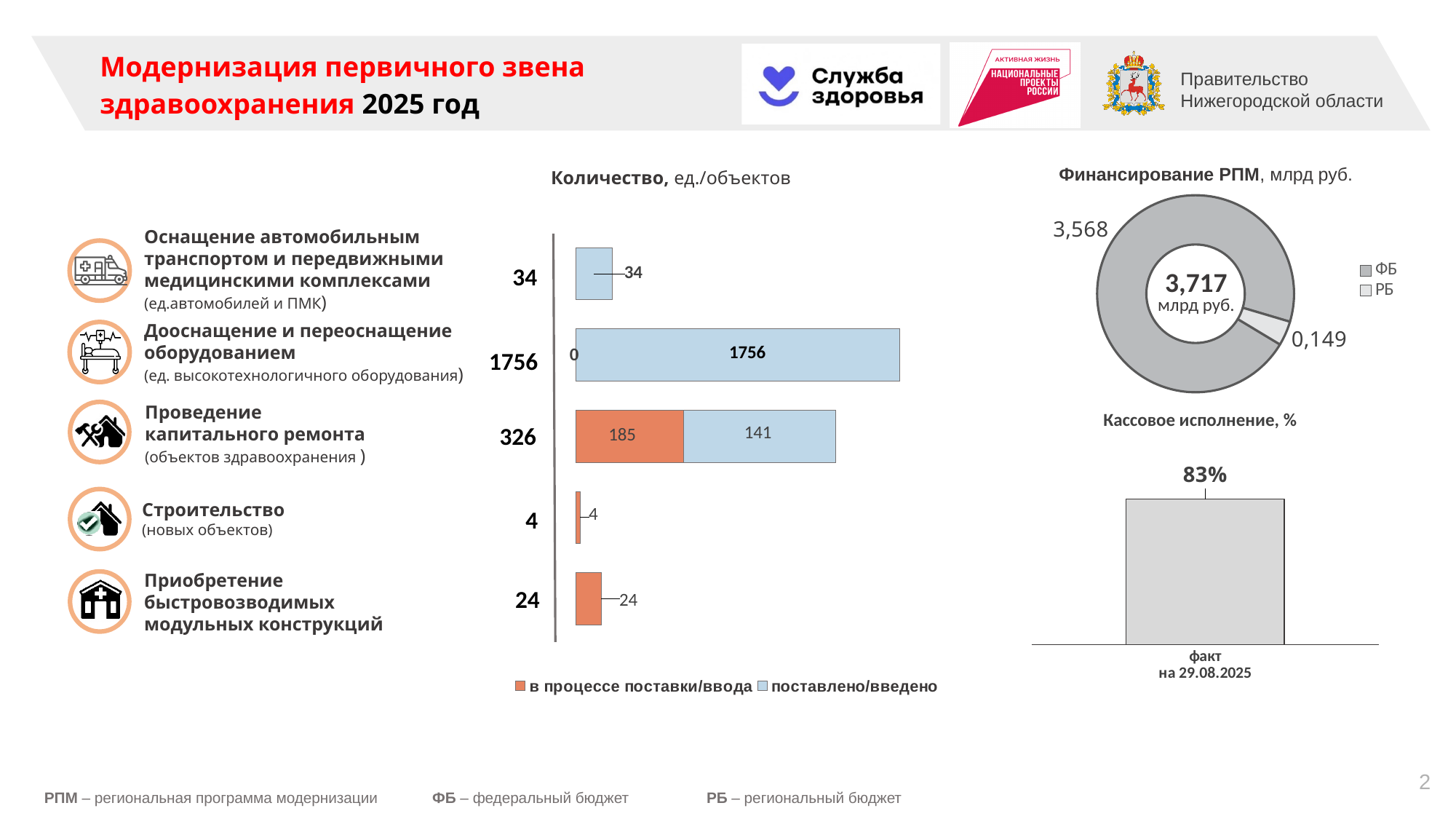
In the 'Финансирование РПМ, млрд руб.' donut chart, what is the value for РБ? 0,149 In the 'Кассовое исполнение, %' chart, what is the value for 'факт на 29.08.2025'? 83% What kind of chart is the 'Количество, ед./объектов' chart? bar chart In the 'Количество, ед./объектов' bar chart, what is the total of the stacked bar for 'Проведение капитального ремонта'? 326 In the 'Количество, ед./объектов' bar chart, what is the difference between the 'в процессе поставки/ввода' and 'поставлено/введено' values for 'Проведение капитального ремонта'? 44 In the 'Количество, ед./объектов' bar chart, what is the value for 'в процессе поставки/ввода' for 'Проведение капитального ремонта'? 185 In the 'Количество, ед./объектов' chart, how many series does the legend list? 2 In the 'Количество, ед./объектов' bar chart, which category has the highest total value? Дооснащение и переоснащение оборудованием In the 'Количество, ед./объектов' bar chart, how many categories are shown? 5 In the 'Количество, ед./объектов' bar chart, which category has the lowest total value? Строительство In the 'Финансирование РПМ, млрд руб.' donut chart, what is the value for ФБ? 3,568 In the 'Количество, ед./объектов' bar chart, what is the value for 'поставлено/введено' for 'Проведение капитального ремонта'? 141